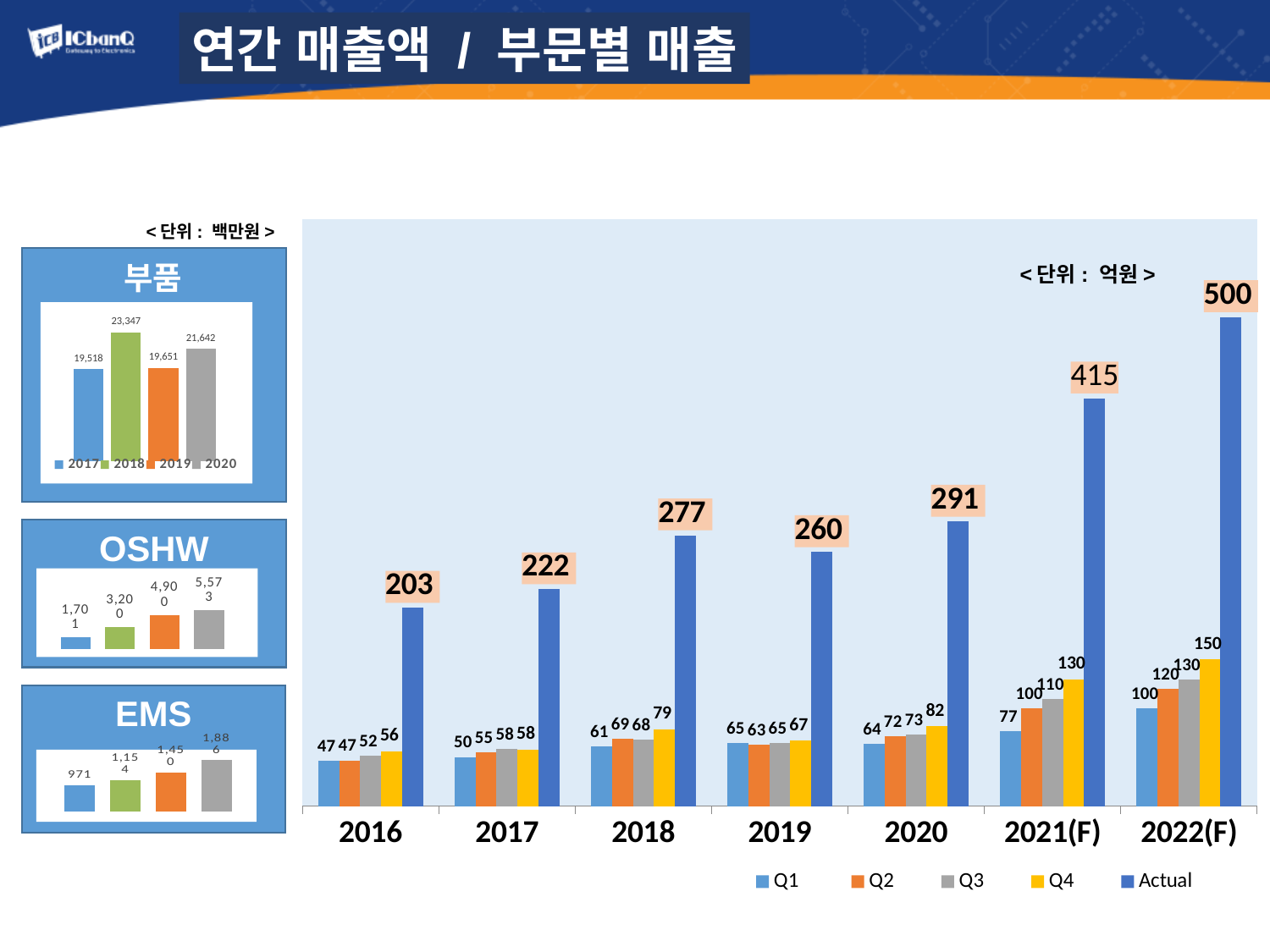
In the large chart on the right, do the Actual values rise or fall from 2019 to 2022(F)? rise In the large chart on the right, how many series does the legend list? 5 In the large chart on the right, how many years are shown on the x axis? 7 What kind of chart is the 부품 chart on the left? bar chart In the large chart on the right, which year has the lowest Actual value? 2016 In the large chart on the right, which is larger: the Q2 value for 2019 or the Q2 value for 2020? 2020 In the large chart on the right, which year has the highest Actual value? 2022(F) In the 부품 chart, what is the value for 2018? 23,347 In the large chart on the right, what is the Actual value for 2018? 277 In the large chart on the right, what is the Q4 value for 2020? 82 In the large chart on the right, what is the difference between the Actual values for 2021(F) and 2020? 124